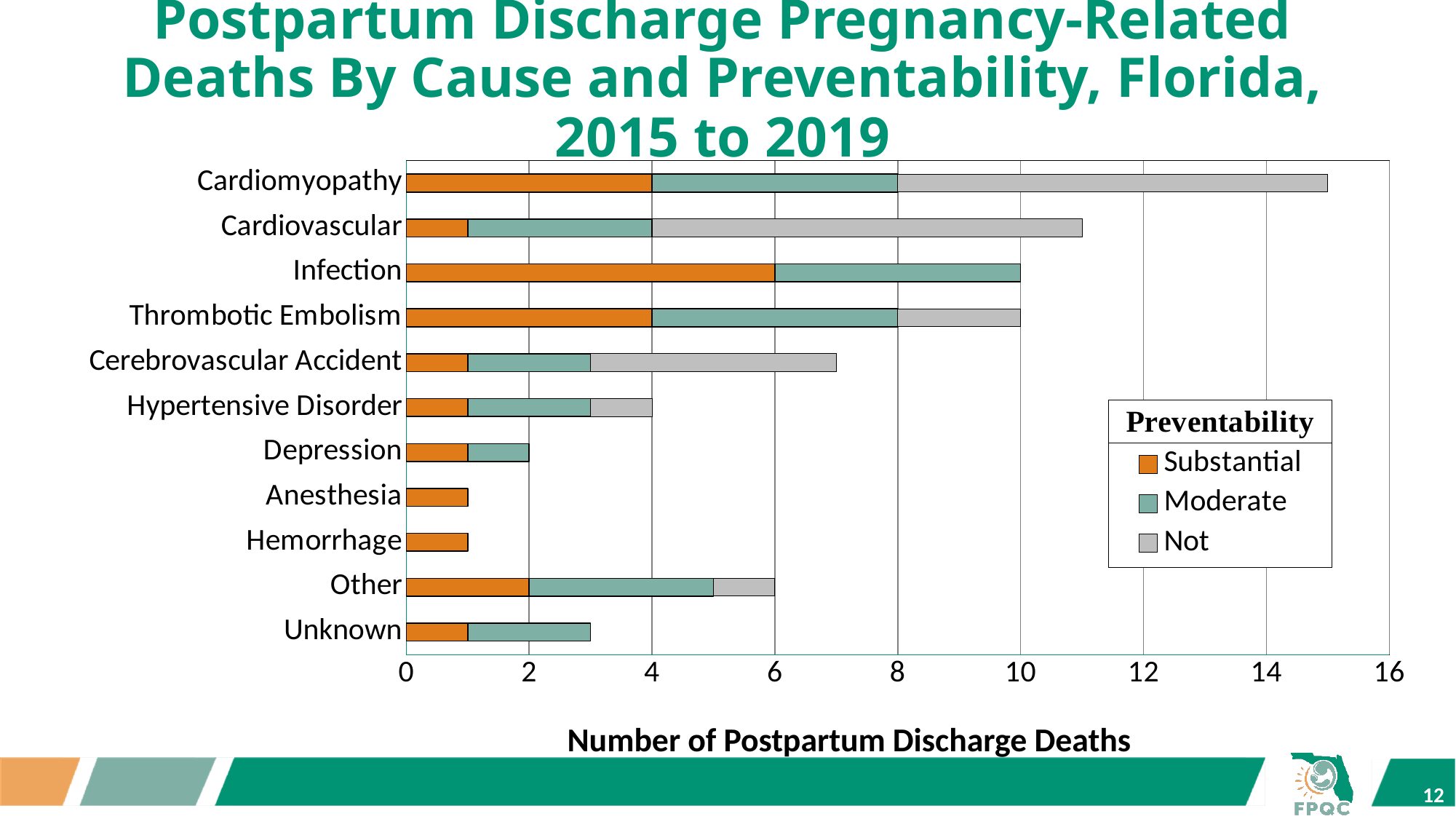
What is the total number of postpartum discharge deaths for Depression? 2 What is the total number of postpartum discharge deaths for Other? 6 How many Cardiomyopathy deaths were classified as Substantial preventability? 4 What is the title of the legend? Preventability Which cause has the highest total number of postpartum discharge deaths? Cardiomyopathy How many preventability series does the legend list? 3 What is the difference between the total deaths for Infection and the total deaths for Other? 4 How many causes of death are listed on the vertical axis? 11 Is the total number of deaths for Cardiomyopathy greater or less than 14? greater What kind of chart is shown on the slide? Stacked bar chart Which has a larger total number of deaths, Cardiomyopathy or Cardiovascular? Cardiomyopathy What is the total number of postpartum discharge deaths for Infection? 10